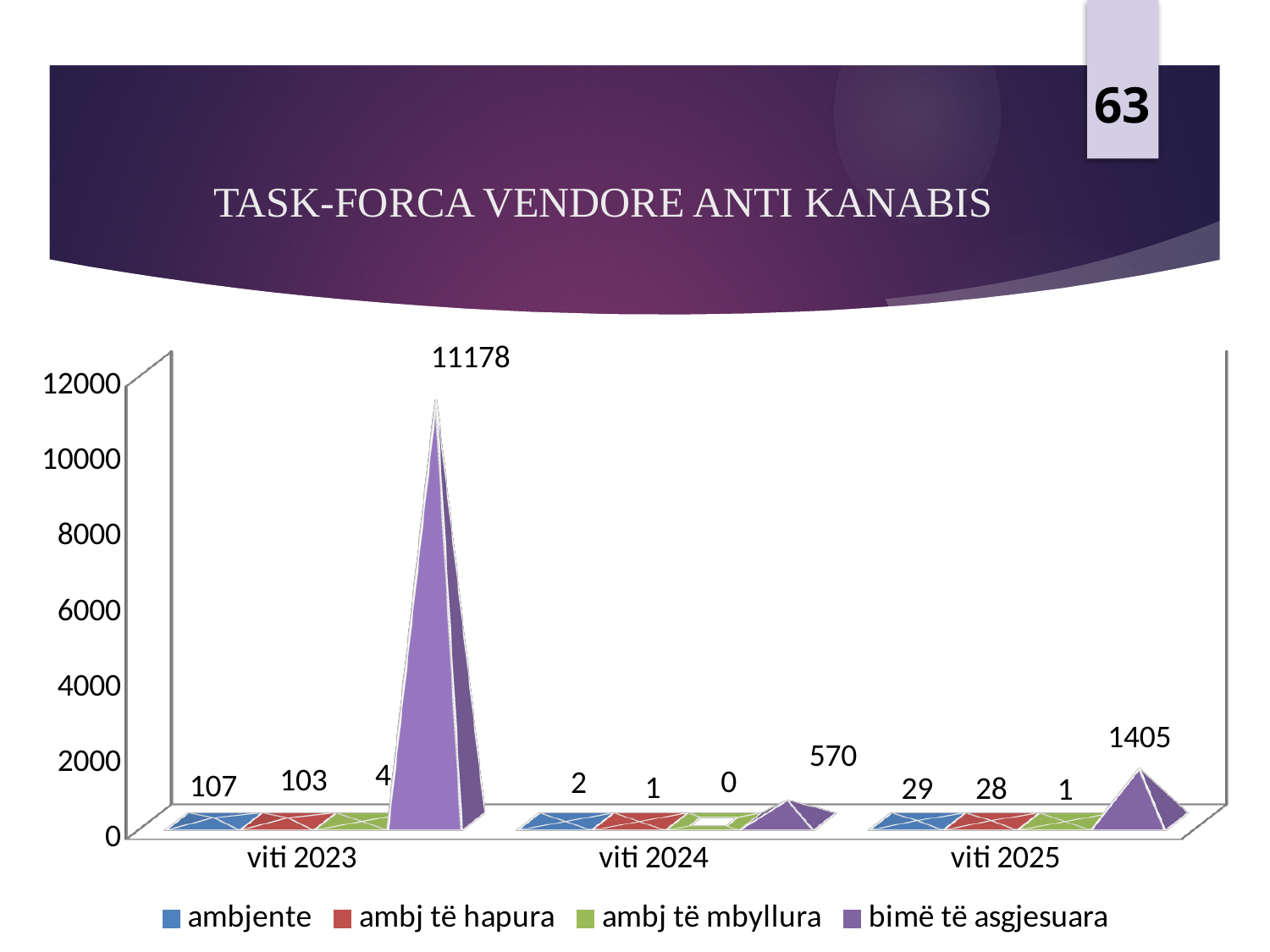
What is the value of 'bimë të asgjesuara' for viti 2023? 11178 How many series does the legend list? 4 Is the value of 'bimë të asgjesuara' for viti 2023 greater or less than 10000? greater What is the difference between 'bimë të asgjesuara' in viti 2025 and viti 2024? 835 In which year is 'bimë të asgjesuara' highest? viti 2023 How many years (categories) are shown on the x axis? 3 Which is larger: 'ambjente' in viti 2023 or 'ambjente' in viti 2025? viti 2023 What is the value of 'ambj të mbyllura' for viti 2024? 0 What kind of chart is shown on the slide? bar chart In which year is 'ambjente' lowest? viti 2024 What is the value of 'ambj të hapura' for viti 2023? 103 What is the value of 'ambjente' for viti 2025? 29